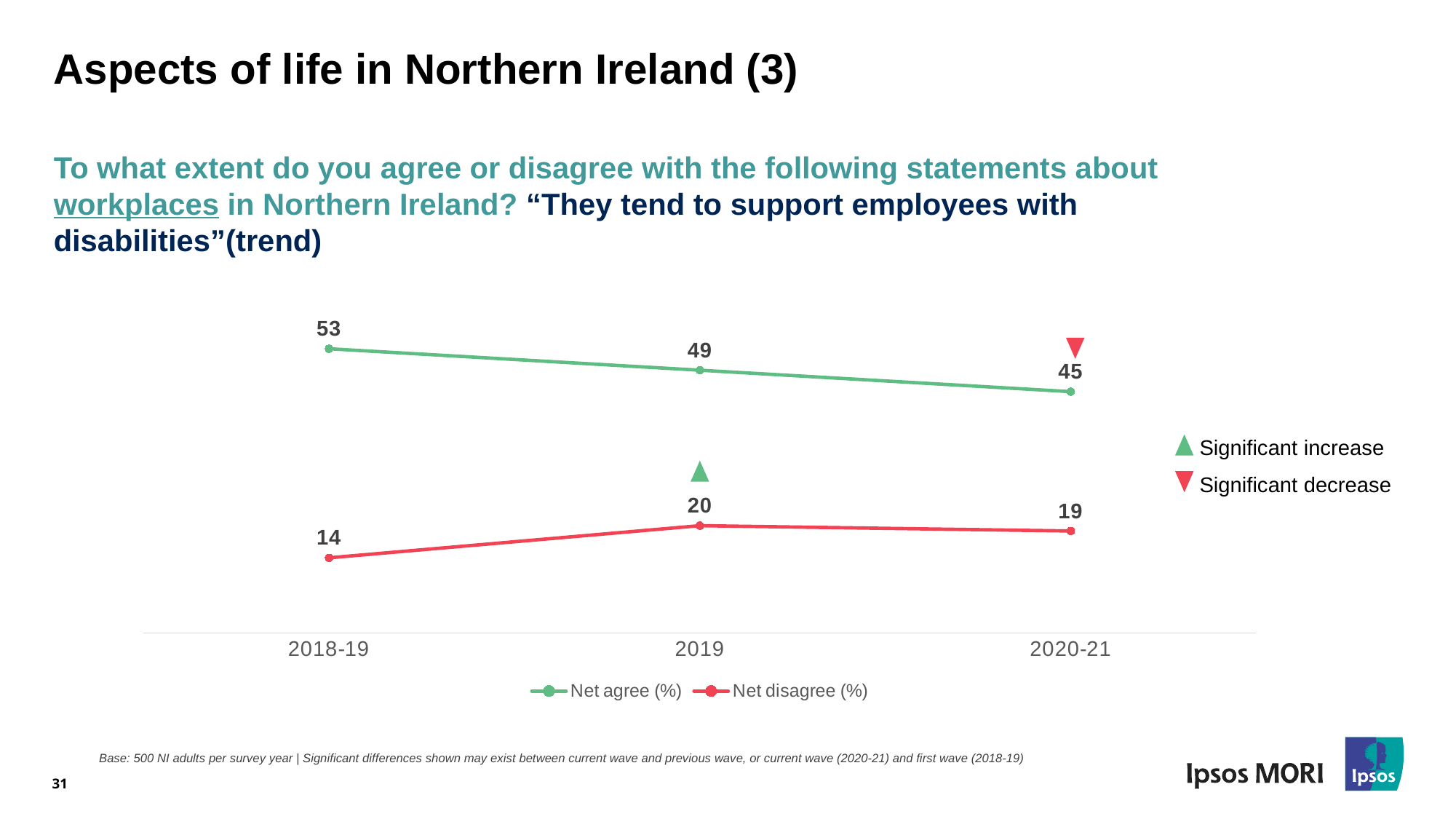
What kind of chart is shown on the slide? Line chart By how much did Net agree (%) fall from 2018-19 to 2020-21? 8 What is the Net agree (%) value for 2018-19? 53 What is the difference between Net agree (%) and Net disagree (%) in 2020-21? 26 What is the Net disagree (%) value for 2019? 20 How many survey years are shown on the x axis? 3 How many series does the legend list? 2 What is the Net agree (%) value for 2020-21? 45 Which is larger in 2019, Net agree (%) or Net disagree (%)? Net agree (%) In which survey year is Net disagree (%) lowest? 2018-19 What is the Net disagree (%) value for 2020-21? 19 In which survey year is Net agree (%) highest? 2018-19